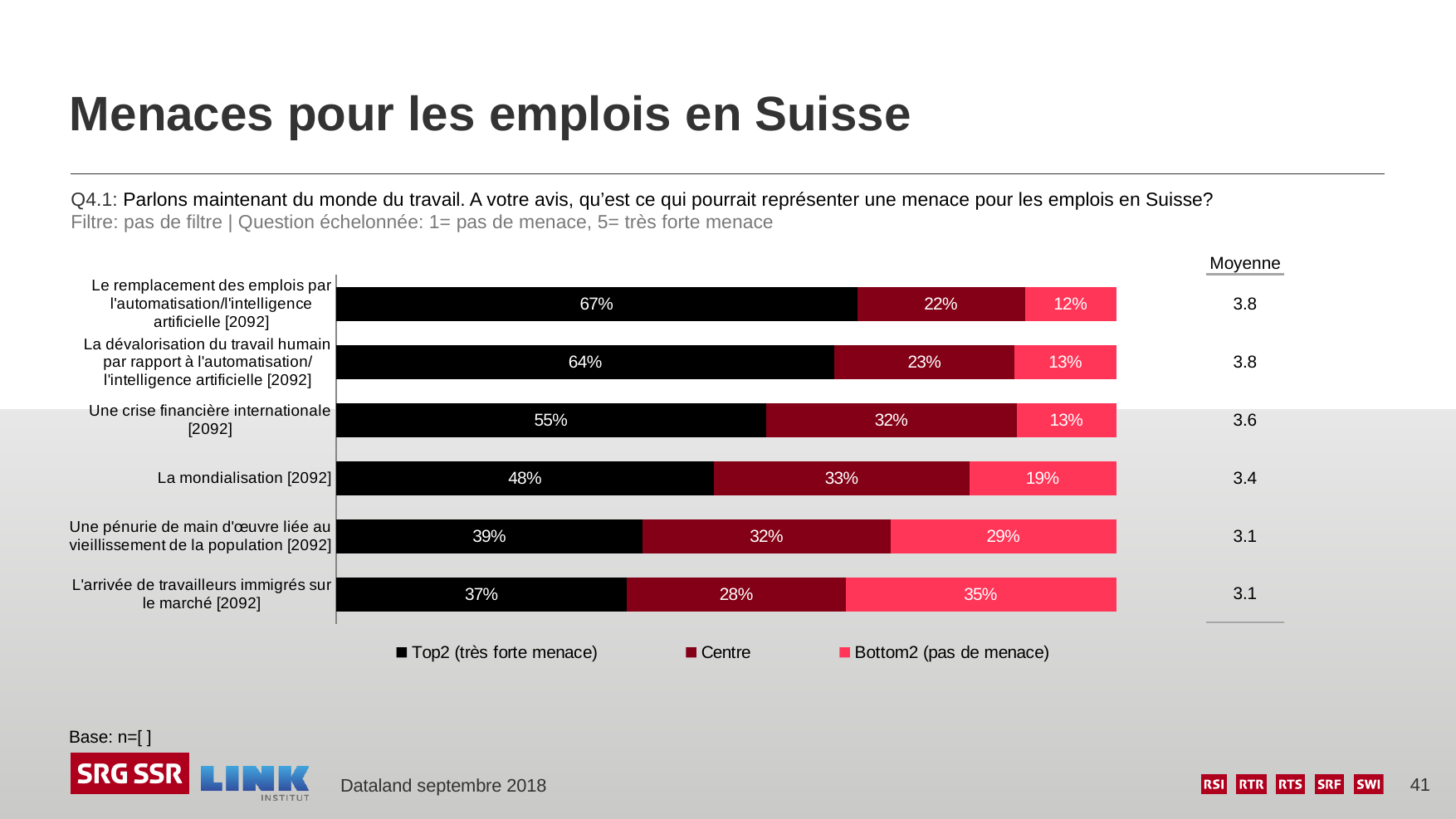
What is the Moyenne value shown for "Une crise financière internationale"? 3.6 Which is larger: the Bottom2 value for "Une pénurie de main d'œuvre liée au vieillissement de la population" or for "La mondialisation"? Une pénurie de main d'œuvre liée au vieillissement de la population What kind of chart is shown on the slide? Stacked bar chart How many series does the legend list? 3 What is the Top2 (très forte menace) value for "Le remplacement des emplois par l'automatisation/l'intelligence artificielle"? 67% What is the Centre value for "La mondialisation"? 33% What is the total of the stacked bar for "La dévalorisation du travail humain par rapport à l'automatisation/l'intelligence artificielle"? 100% What is the Bottom2 (pas de menace) value for "L'arrivée de travailleurs immigrés sur le marché"? 35% How many categories are shown in the chart? 6 What is the difference between the Top2 values for "Une crise financière internationale" and "La mondialisation"? 7% Which category has the lowest Top2 (très forte menace) value? L'arrivée de travailleurs immigrés sur le marché Which category has the highest Top2 (très forte menace) value? Le remplacement des emplois par l'automatisation/l'intelligence artificielle